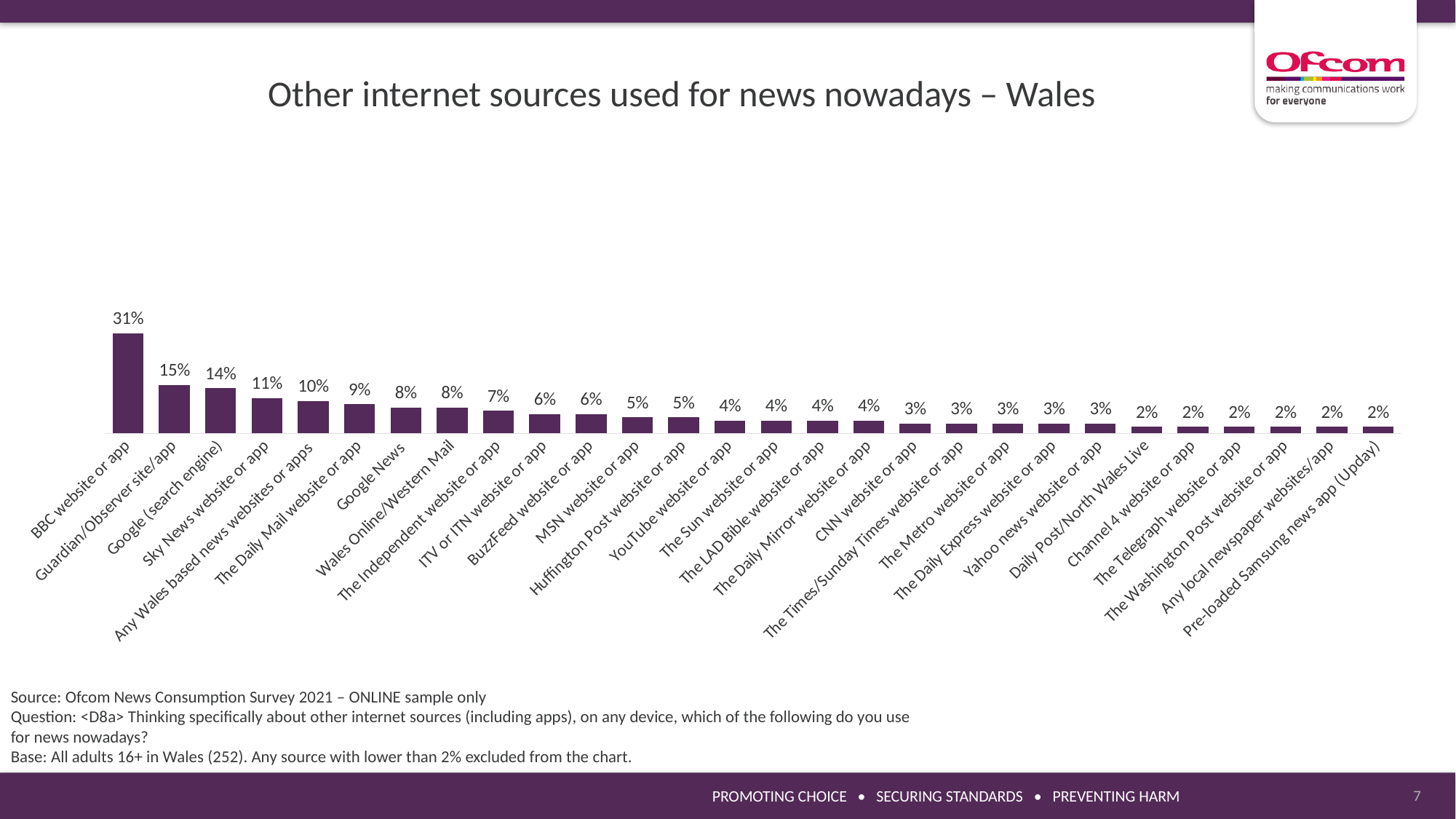
What is the title of the chart? Other internet sources used for news nowadays – Wales What percentage is shown for Wales Online/Western Mail? 8% What type of chart is shown on the slide? Bar chart What is the difference between Sky News website or app and The Daily Mail website or app? 2% What is the difference between the BBC website or app and the Guardian/Observer site/app? 16% How many sources are shown on the chart? 28 What is the value for the Huffington Post website or app? 5% What is the value for Pre-loaded Samsung news app (Upday)? 2% What is the value for Google (search engine)? 14% Which is larger, the value for Google News or the value for MSN website or app? Google News What percentage of respondents use the BBC website or app for news? 31% Which source has the highest value on the chart? BBC website or app